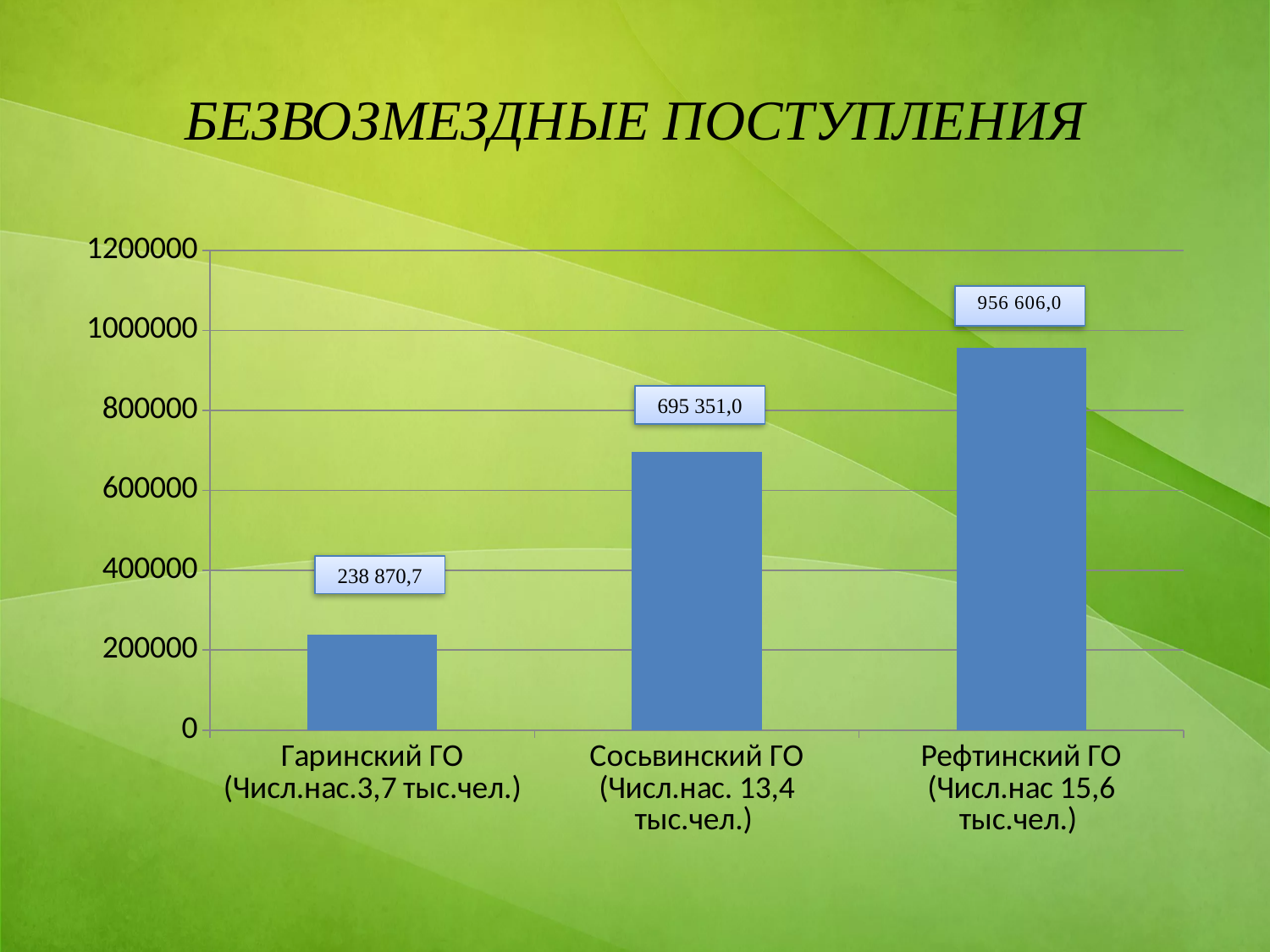
What is the value shown for Гаринский ГО? 238 870,7 What is the value shown for Рефтинский ГО? 956 606,0 Which category has the lowest value? Гаринский ГО Which is larger, the value for Сосьвинский ГО or the value for Гаринский ГО? Сосьвинский ГО What is the difference between the values for Сосьвинский ГО and Гаринский ГО? 456 480,3 What kind of chart is shown on the slide? bar chart How many categories are shown on the chart? 3 Which category has the highest value? Рефтинский ГО What is the value shown for Сосьвинский ГО? 695 351,0 What is the title of the slide? БЕЗВОЗМЕЗДНЫЕ ПОСТУПЛЕНИЯ Is the value for Рефтинский ГО greater or less than 800000? greater What is the difference between the values for Рефтинский ГО and Сосьвинский ГО? 261 255,0